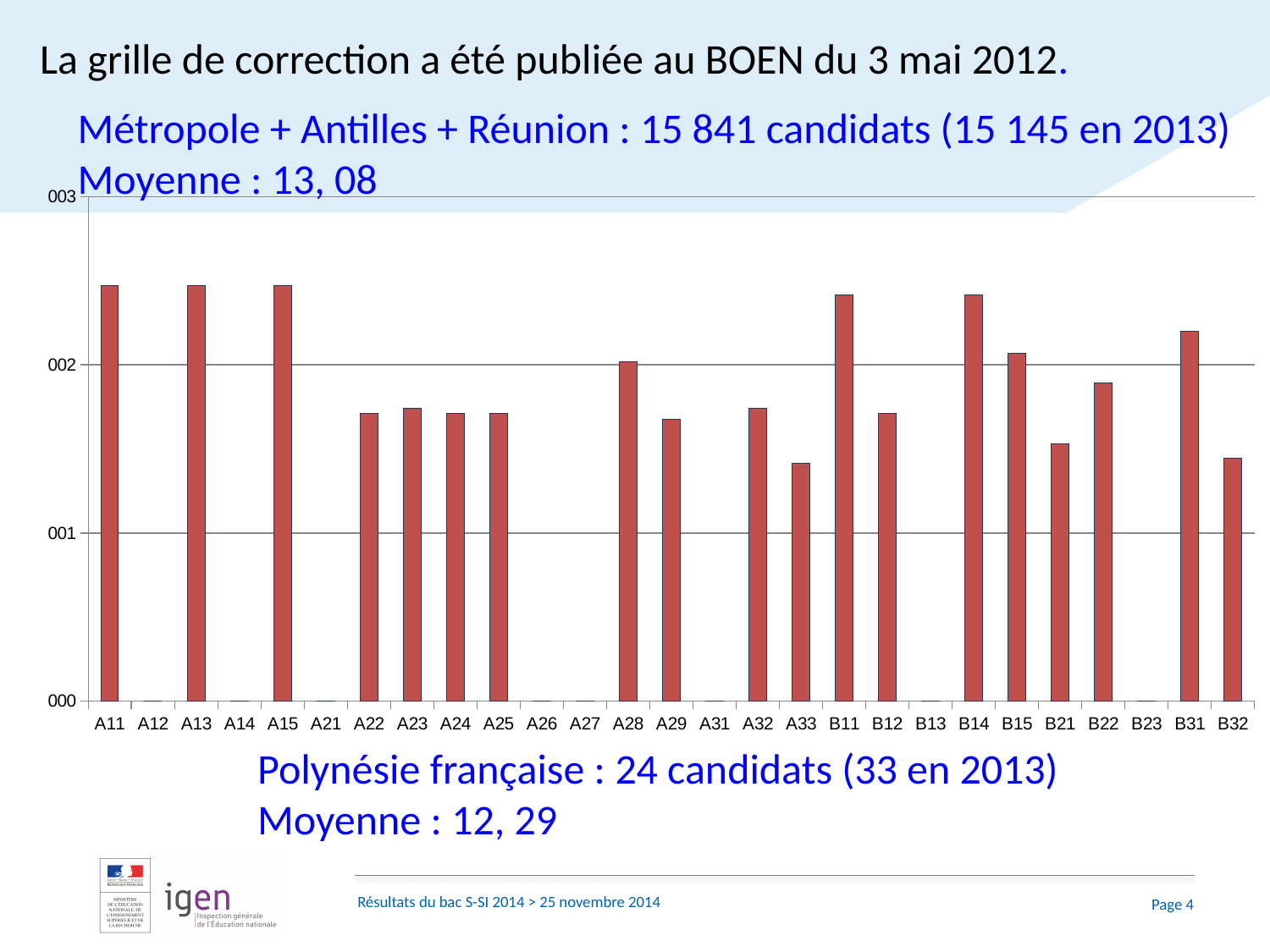
Is the value for A33 greater or less than 002? less Is the value for B31 greater or less than 002? greater Which is larger, the value for A11 or the value for A33? A11 What is the highest tick label shown on the y axis of the chart? 003 Is the value for B22 greater or less than 001? greater Which is larger, the value for A28 or the value for A29? A28 What kind of chart is shown on the slide? bar chart Which is larger, the value for B14 or the value for B21? B14 How many categories are shown on the x axis of the chart? 27